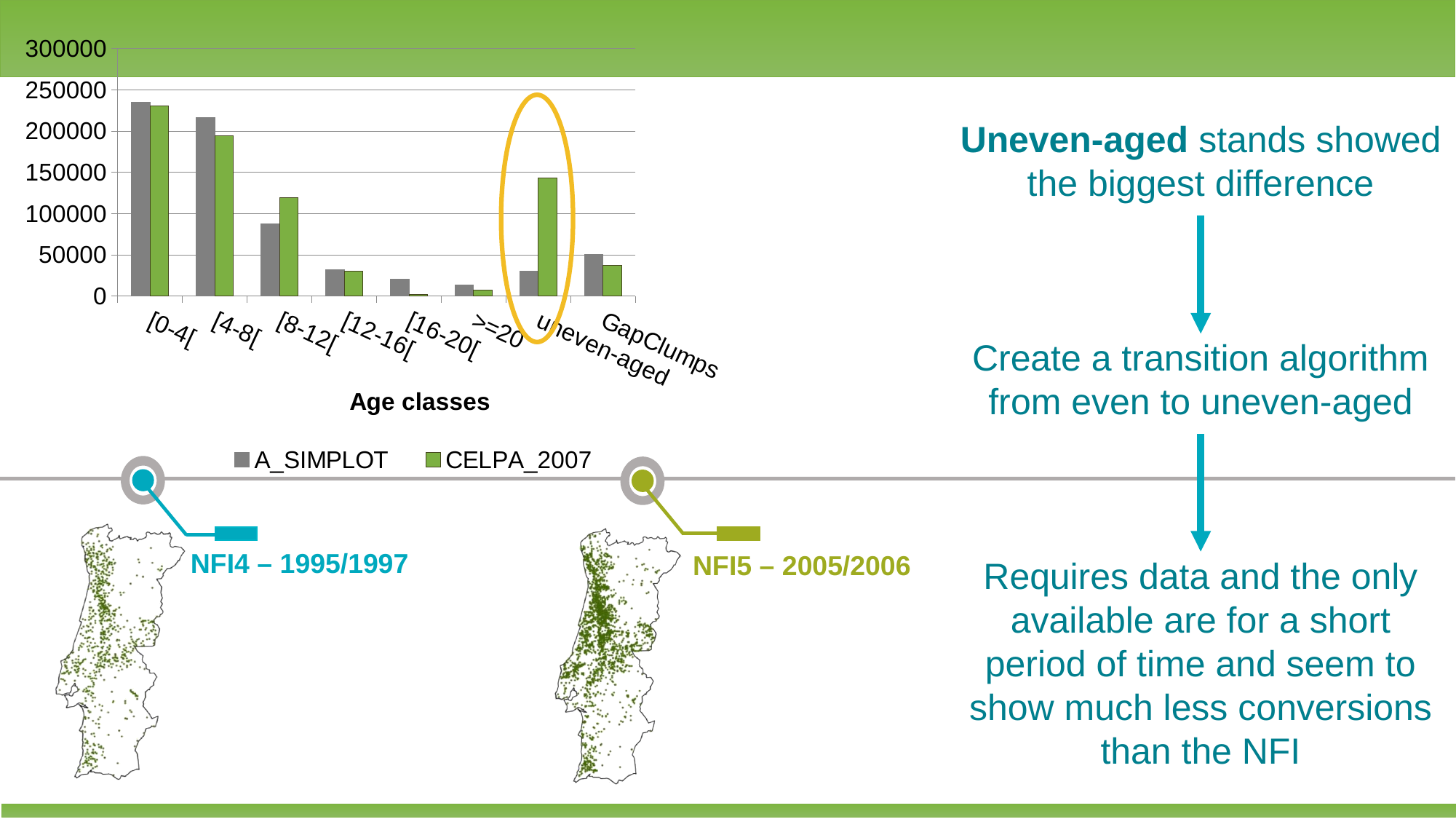
Which category has the highest A_SIMPLOT value? [0-4[ Is the CELPA_2007 value for uneven-aged greater or less than 100000? greater For the [8-12[ category, which series has the larger value, A_SIMPLOT or CELPA_2007? CELPA_2007 What kind of chart is shown on the slide? bar chart Is the A_SIMPLOT value for [0-4[ greater or less than 200000? greater What is the title of the x axis of the chart? Age classes How many categories are shown on the x axis of the chart? 8 How many series does the chart's legend list? 2 Which category has the lowest CELPA_2007 value? [16-20[ For the GapClumps category, which series has the larger value, A_SIMPLOT or CELPA_2007? A_SIMPLOT Do the A_SIMPLOT values rise or fall from [0-4[ to >=20? fall For the uneven-aged category, which series has the larger value, A_SIMPLOT or CELPA_2007? CELPA_2007